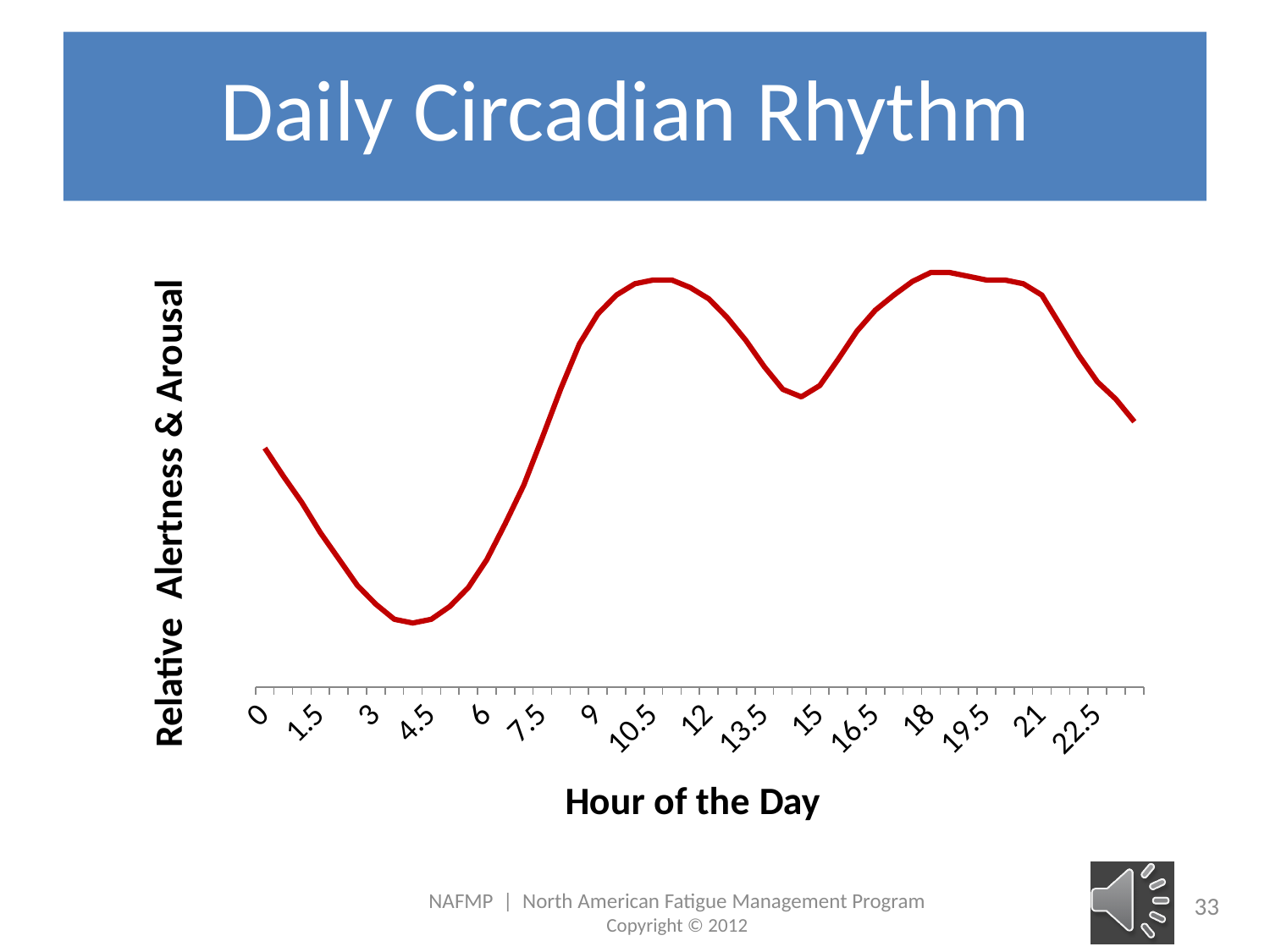
Which has the higher relative alertness value, hour 15 or hour 18? 18 How many lines are plotted on the chart? 1 Does the line rise or fall between hour 21 and hour 22.5? fall Does the line rise or fall between hour 0 and hour 3? fall What is the label of the x axis of the chart? Hour of the Day Does the line rise or fall between hour 6 and hour 9? rise Which has the higher relative alertness value, hour 4.5 or hour 12? 12 Which has the lower relative alertness value, hour 0 or hour 9? 0 What is the title of the chart on the slide? Daily Circadian Rhythm What kind of chart is shown on the slide? line chart How many hour labels are printed along the x axis of the chart? 16